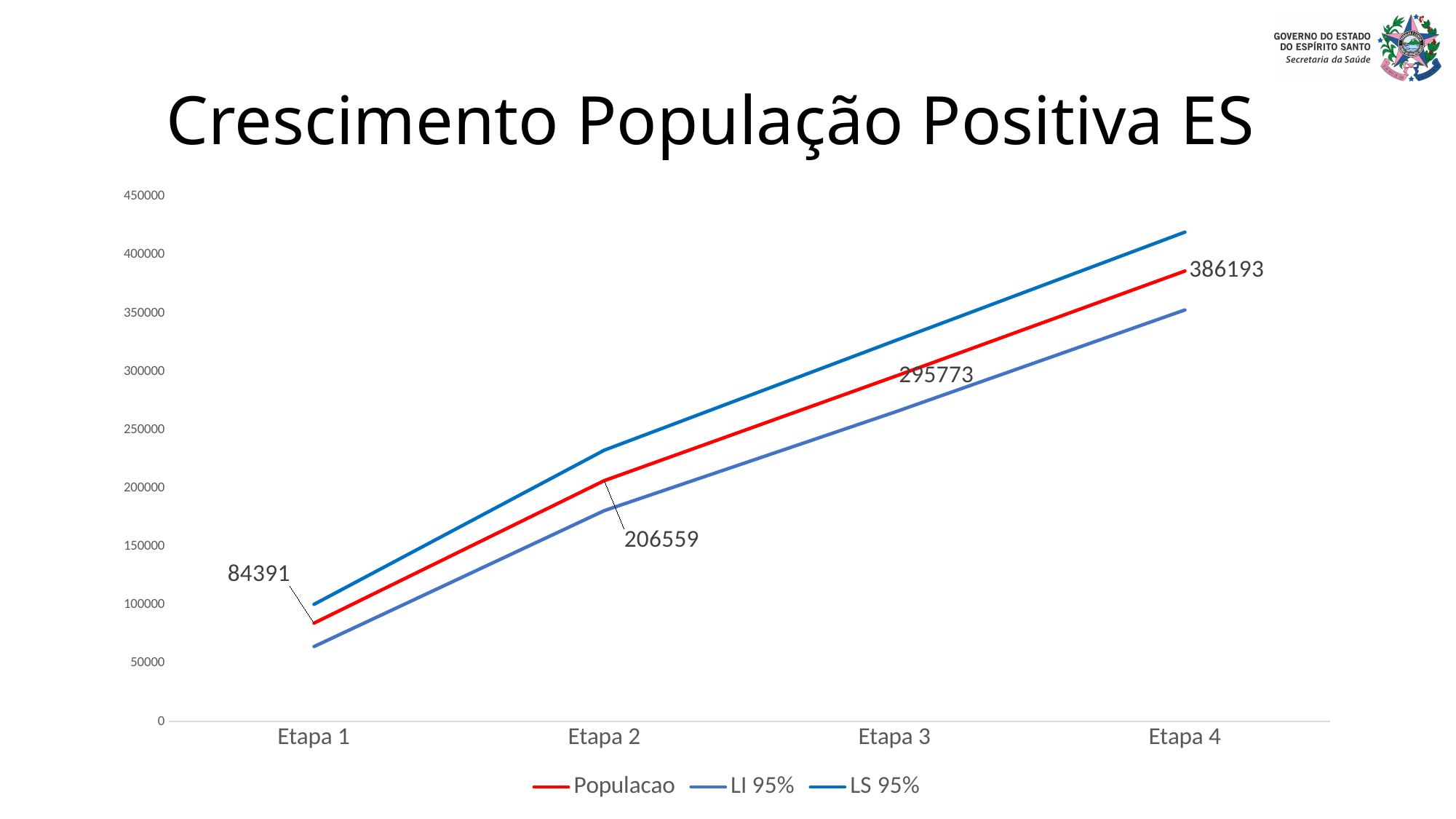
Does the Populacao series rise or fall from Etapa 1 to Etapa 4? rise How many series does the legend list? 3 What is the difference between the Populacao values at Etapa 3 and Etapa 2? 89214 At which Etapa is the Populacao series lowest? Etapa 1 Is the LS 95% value at Etapa 4 greater or less than 400000? greater What is the Populacao value at Etapa 1? 84391 What is the Populacao value at Etapa 2? 206559 What is the difference between the Populacao values at Etapa 4 and Etapa 1? 301802 What is the Populacao value at Etapa 4? 386193 Is the LI 95% value at Etapa 1 greater or less than 100000? less At which Etapa is the Populacao series highest? Etapa 4 How many Etapas are shown on the x axis? 4